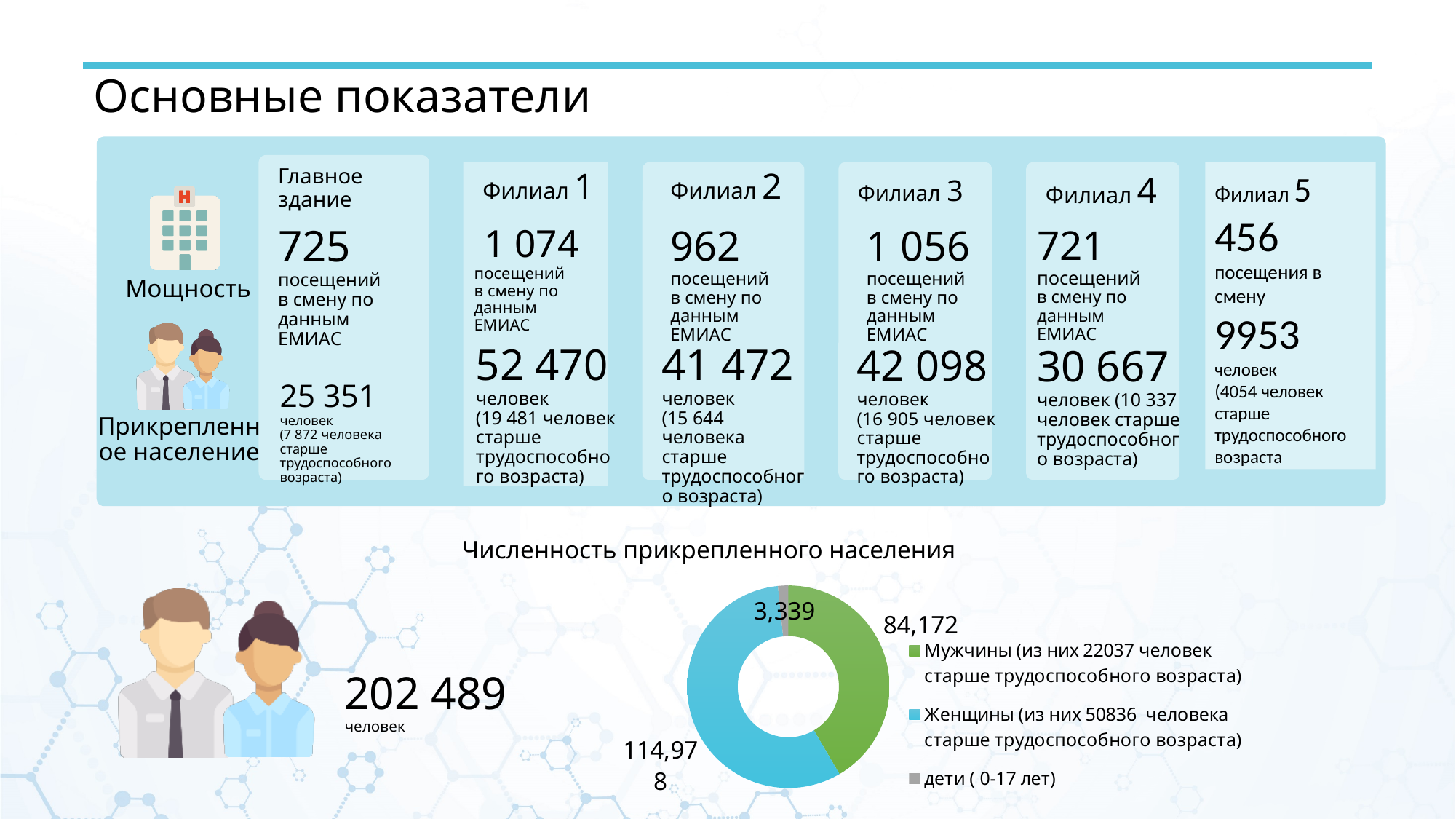
What is the total of all slices in the "Численность прикрепленного населения" chart? 202,489 In the "Численность прикрепленного населения" chart, what is the value for Мужчины? 84,172 In the "Численность прикрепленного населения" chart, what is the difference between the values for Женщины and Мужчины? 30,806 In the "Численность прикрепленного населения" chart, which is larger: the value for Мужчины or the value for дети (0-17 лет)? Мужчины How many categories does the "Численность прикрепленного населения" chart show? 3 How many entries does the legend of the "Численность прикрепленного населения" chart list? 3 What kind of chart is shown under the title "Численность прикрепленного населения"? Doughnut (pie) chart Which category has the largest slice in the "Численность прикрепленного населения" chart? Женщины In the "Численность прикрепленного населения" chart, what colour is the Женщины slice? Blue Which category has the smallest slice in the "Численность прикрепленного населения" chart? дети (0-17 лет) In the "Численность прикрепленного населения" chart, what is the value for Женщины? 114,978 In the "Численность прикрепленного населения" chart, what is the value for дети (0-17 лет)? 3,339